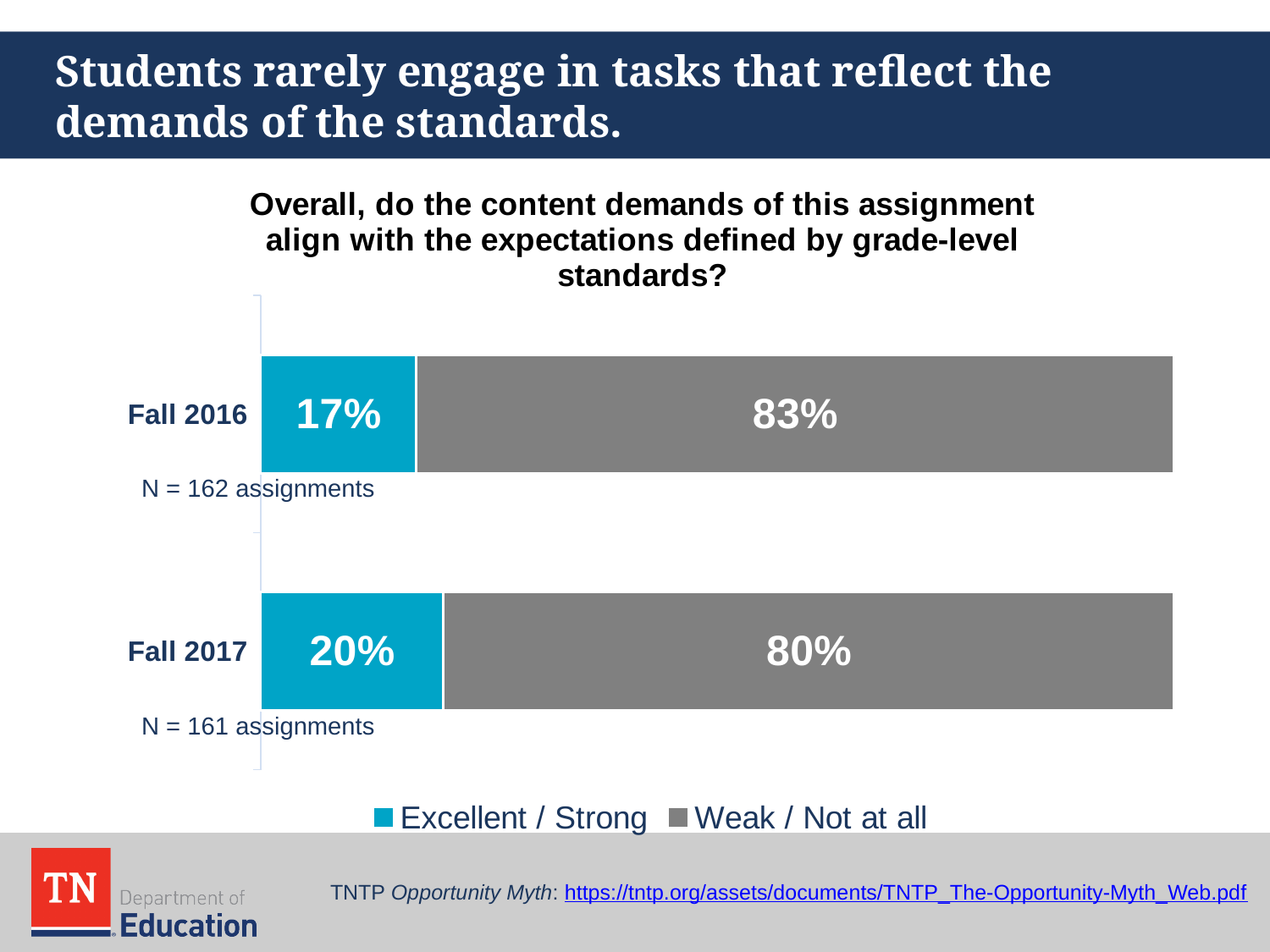
Which year had the higher share of assignments rated Excellent / Strong? Fall 2017 How many series does the legend list? 2 Did the Weak / Not at all percentage rise or fall from Fall 2016 to Fall 2017? Fall What percentage of Fall 2017 assignments were rated Weak / Not at all? 80% What percentage of Fall 2016 assignments were rated Excellent / Strong? 17% What is the total of the two segments in the Fall 2016 bar? 100% What percentage of Fall 2017 assignments were rated Excellent / Strong? 20% How many assignments were included in the Fall 2017 sample? 161 assignments What kind of chart is shown on the slide? Stacked bar chart How many categories (years) are shown on the chart? 2 What is the difference in the Excellent / Strong percentage between Fall 2017 and Fall 2016? 3% What percentage of Fall 2016 assignments were rated Weak / Not at all? 83%